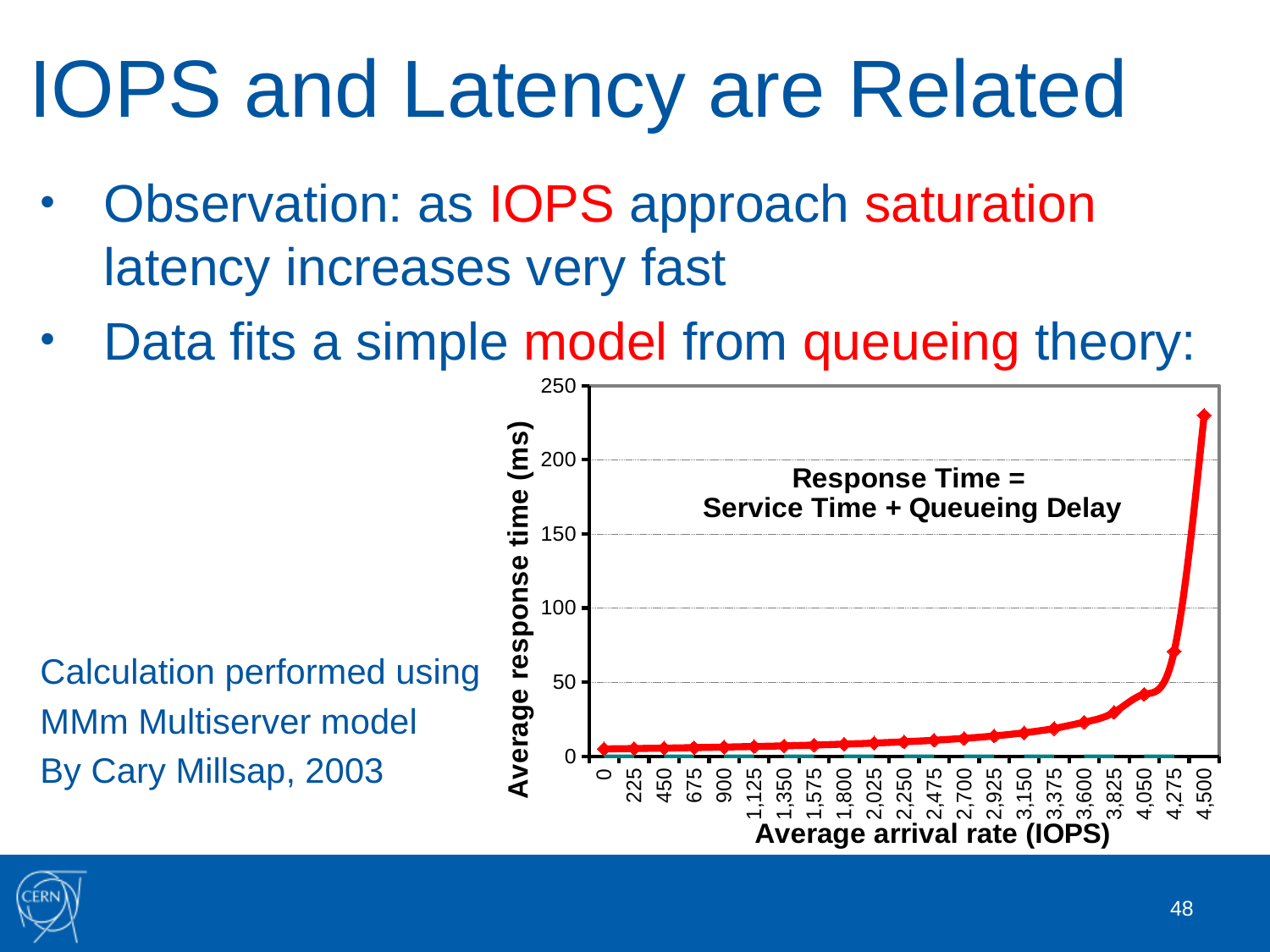
Is the average response time at an arrival rate of 4,500 IOPS greater or less than 200 ms? greater How many tick labels are shown on the x axis of the chart? 21 Does the average response time rise or fall as the average arrival rate increases along the x axis? rises Is the average response time at an arrival rate of 4,275 IOPS greater or less than 50 ms? greater At which arrival rate is the average response time highest? 4,500 What is the title of the x axis of the chart? Average arrival rate (IOPS) Is the average response time at an arrival rate of 2,250 IOPS greater or less than 50 ms? less What is the title of the y axis of the chart? Average response time (ms) Which has the higher average response time: an arrival rate of 4,500 IOPS or 4,050 IOPS? 4,500 What kind of chart is shown on the slide? line chart What is the highest value labelled on the y axis of the chart? 250